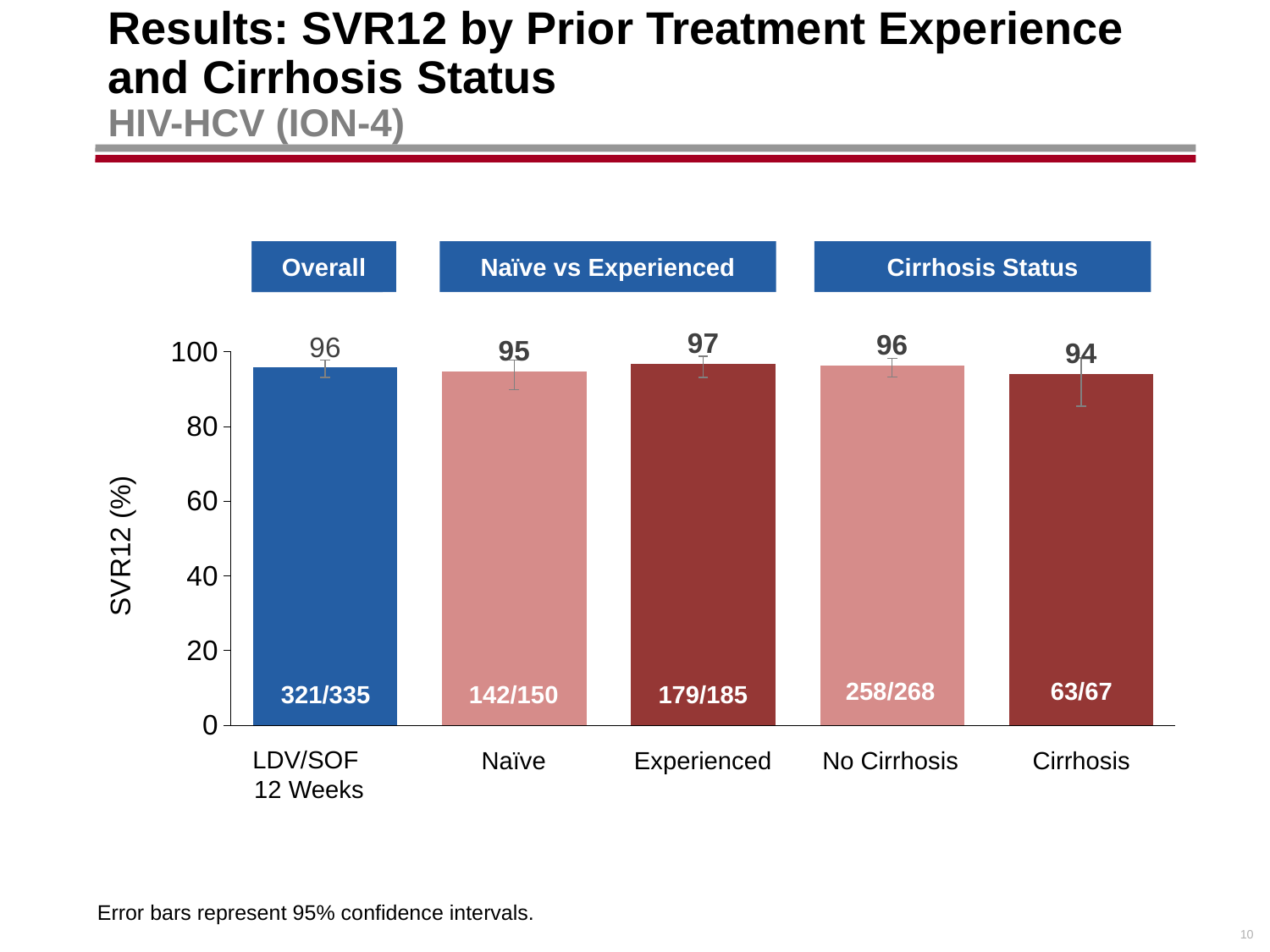
What type of chart is shown on the slide? Bar chart What fraction of patients is printed on the No Cirrhosis bar? 258/268 How many bars are shown in the chart? 5 Which group has the lowest SVR12 value? Cirrhosis What is the SVR12 value for the LDV/SOF 12 Weeks overall group? 96 What is the difference in SVR12 between the Experienced and Naïve groups? 2 What fraction of patients is printed on the Naïve bar? 142/150 What is the SVR12 value for the Experienced group? 97 Which has a higher SVR12 value, No Cirrhosis or Cirrhosis? No Cirrhosis What is the SVR12 value for the Cirrhosis group? 94 Which group has the highest SVR12 value? Experienced What is the label of the y axis? SVR12 (%)